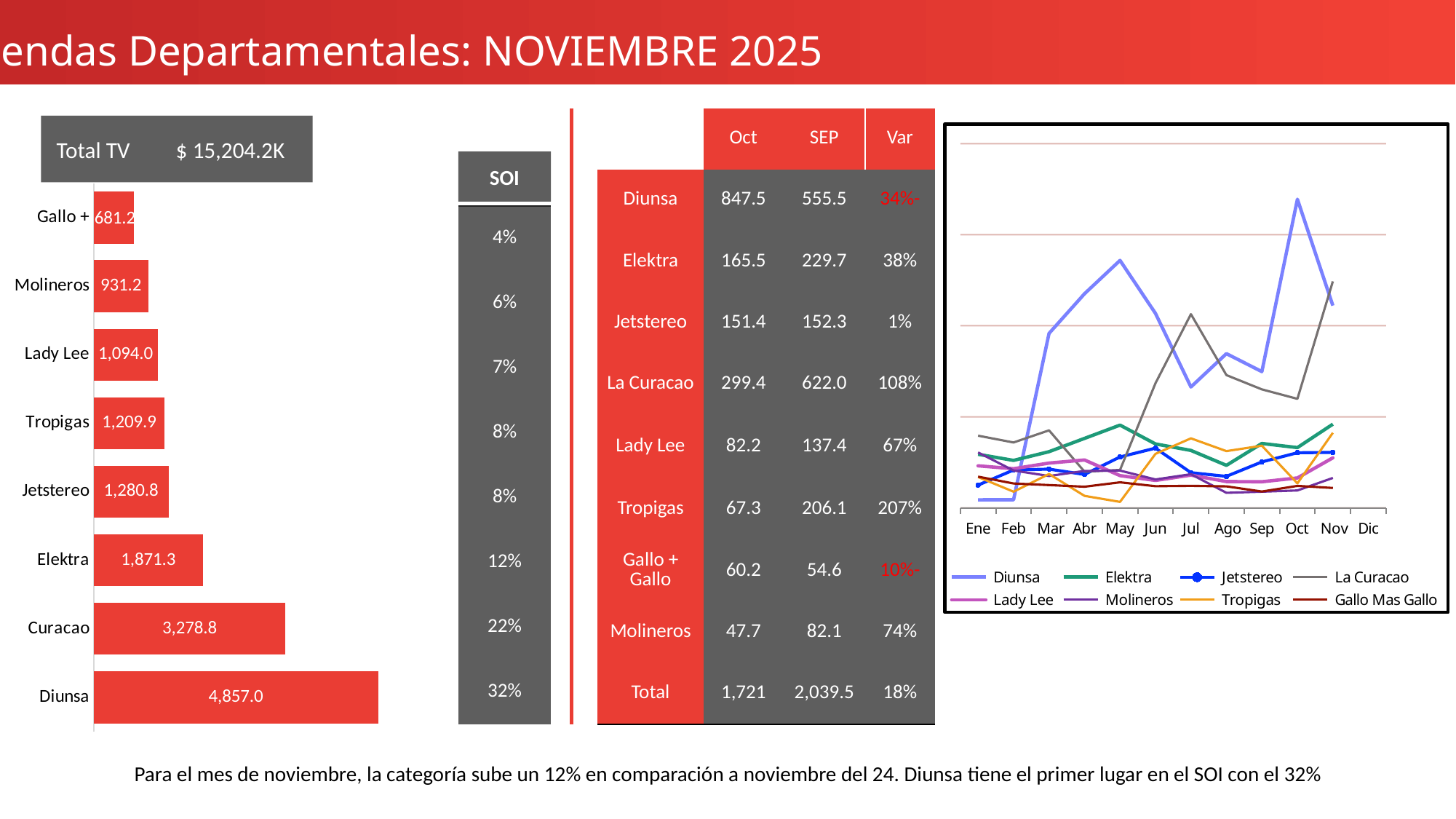
What kind of chart is the chart on the right of the slide? Line chart On the bar chart on the left, what is the value for Diunsa? 4,857.0 On the bar chart on the left, which category has the highest value? Diunsa On the bar chart on the left, what is the difference between the values for Curacao and Elektra? 1,407.5 On the bar chart on the left, what is the value for Tropigas? 1,209.9 On the bar chart on the left, which category has the lowest value? Gallo + On the bar chart on the left, which is larger, the value for Jetstereo or the value for Lady Lee? Jetstereo On the bar chart on the left, what is the value for Elektra? 1,871.3 How many series does the legend of the line chart on the right list? 8 How many categories are shown on the bar chart on the left? 8 On the line chart on the right, does the Diunsa line rise or fall from Feb to May? Rise What kind of chart is the chart on the left of the slide? Bar chart